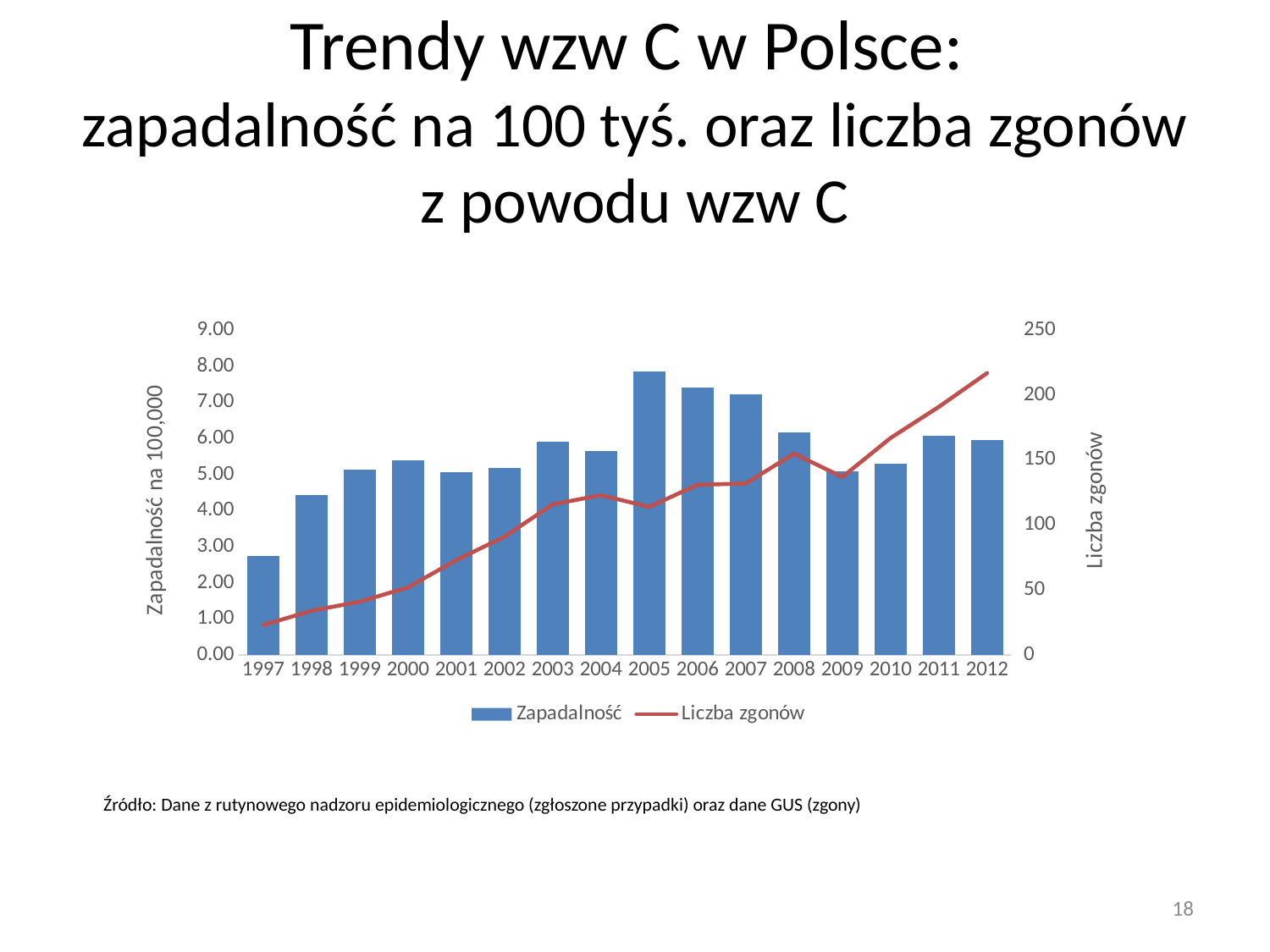
Is the Liczba zgonów value for 2012 greater or less than 200? greater What kind of chart is shown on the slide? A combined bar and line chart Which year has the highest Zapadalność bar? 2005 Which year has the lowest Zapadalność bar? 1997 Which year has the larger Zapadalność value, 2006 or 2009? 2006 Which series is drawn as a line in the chart? Liczba zgonów How many series does the chart legend list? 2 Is the Zapadalność value for 2005 greater or less than 7.00? greater Is the Liczba zgonów value for 1997 greater or less than 50? less Does the Liczba zgonów line generally rise or fall from 1997 to 2012? rise How many years are shown on the x axis of the chart? 16